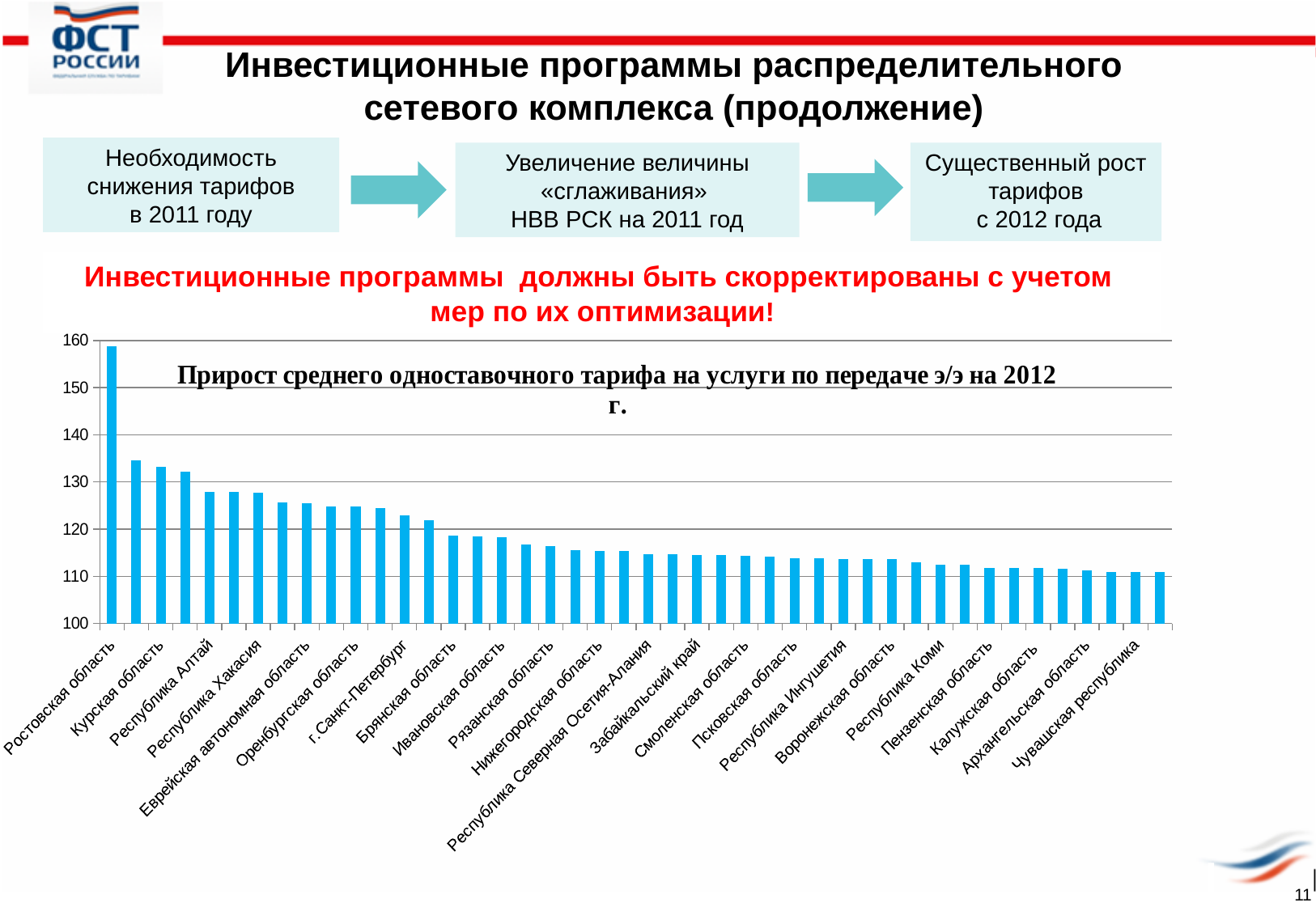
Is the value for Республика Алтай greater or less than 120? greater Which region has the highest value in the chart? Ростовская область What kind of chart is shown on the slide? bar chart Is the value for Смоленская область greater or less than 120? less Which labelled region has the lowest value in the chart? Чувашская республика Which is larger, the value for Курская область or the value for Псковская область? Курская область Is the value for Чувашская республика greater or less than 120? less Which is larger, the value for Ростовская область or the value for Курская область? Ростовская область Do the values rise or fall from left to right along the x axis? fall What is the title of the chart? Прирост среднего одноставочного тарифа на услуги по передаче э/э на 2012 г.